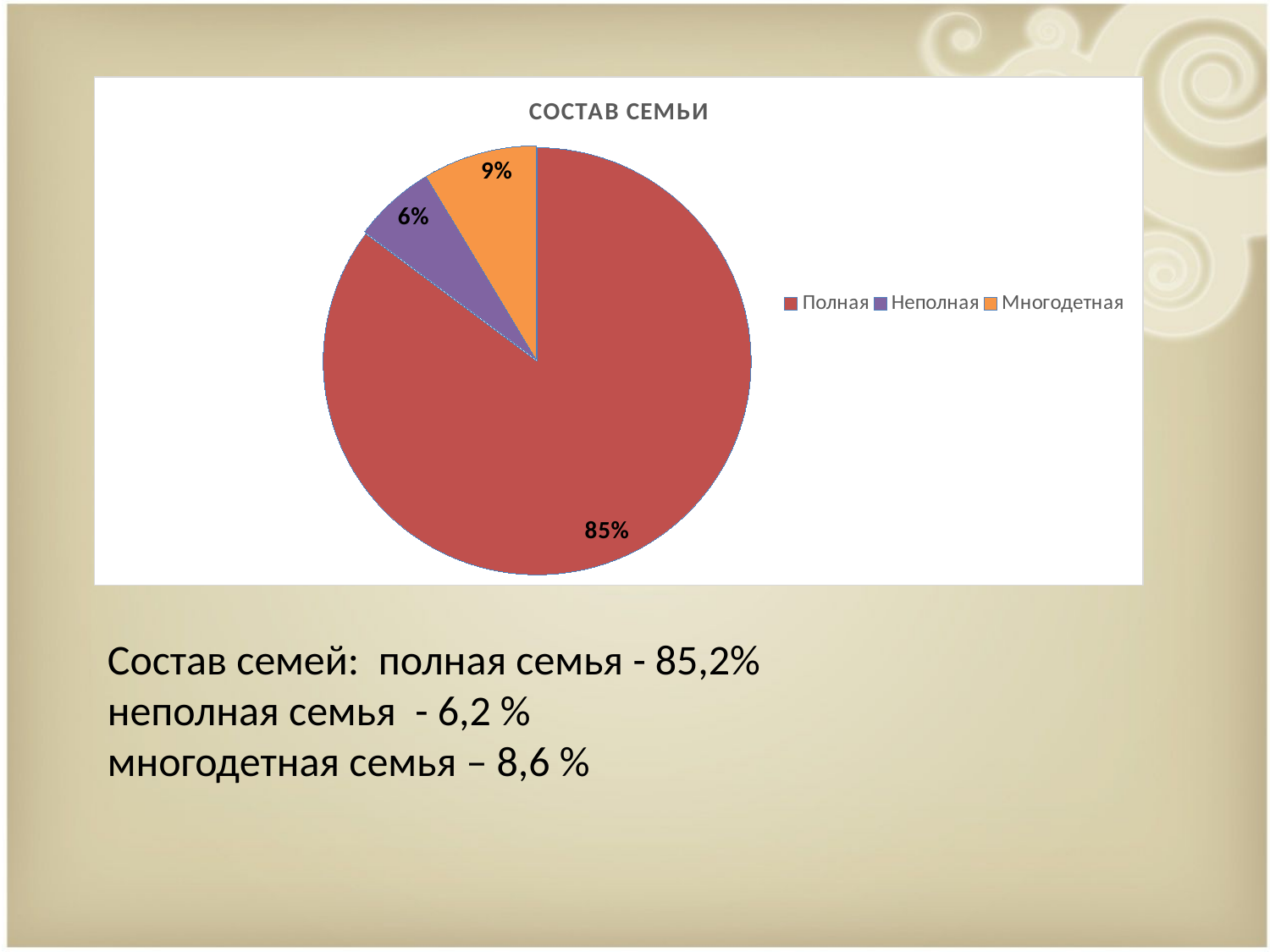
What is the title of the chart? СОСТАВ СЕМЬИ What percentage does the Неполная slice show? 6% What is the difference in percentage points between the Полная and Многодетная slices? 76 What type of chart is shown on the slide? pie chart What colour is the Многодетная slice? orange Which category has the smallest slice of the pie? Неполная What percentage does the Многодетная slice show? 9% Which category has the largest slice of the pie? Полная How many slices does the pie chart have? 3 What percentage does the Полная slice show? 85% How many entries does the legend list? 3 Which slice is larger, Неполная or Многодетная? Многодетная